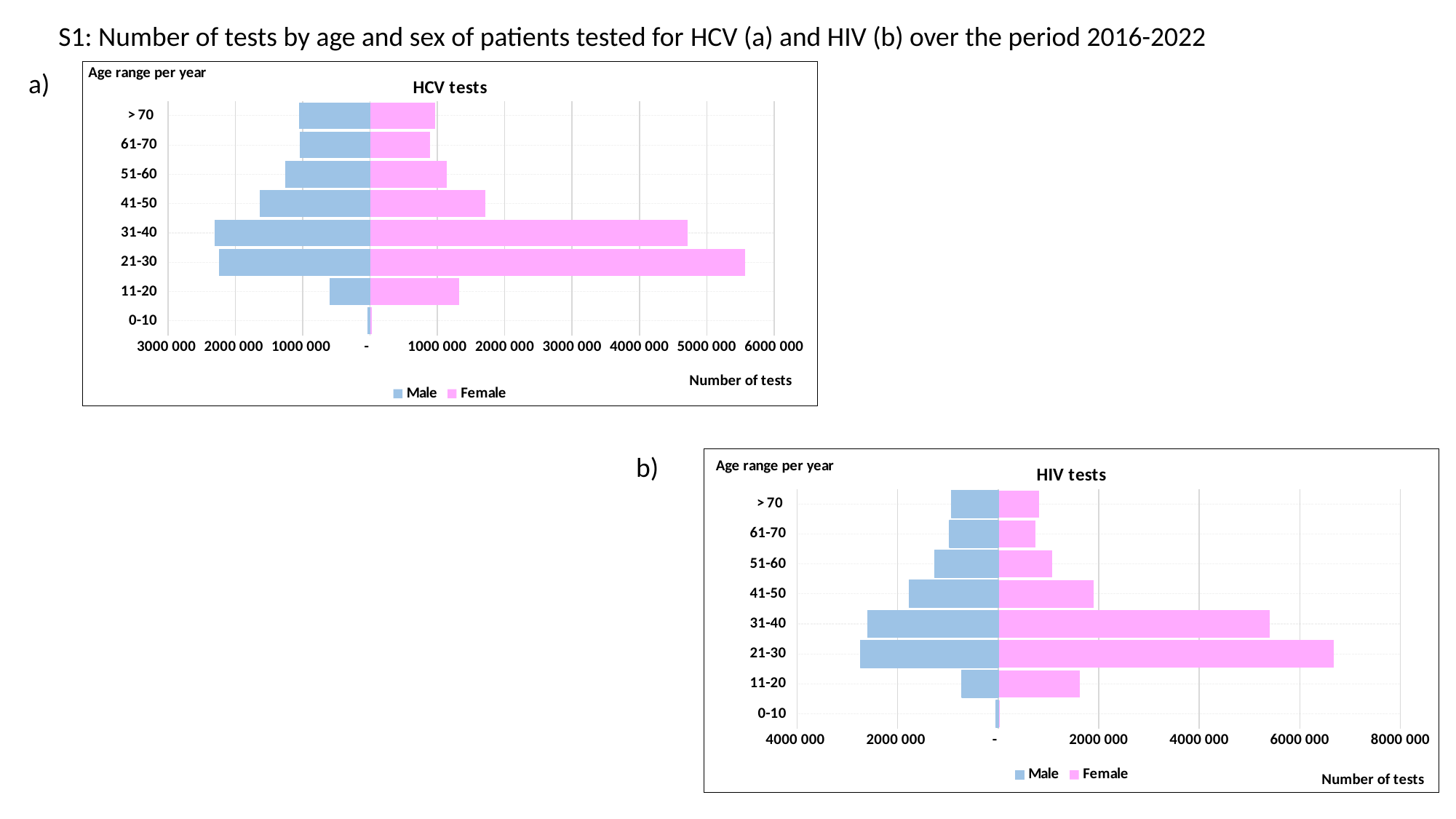
On the HIV tests chart, which age range has the lowest number of Male tests? 0-10 What is the x-axis label of the HIV tests chart? Number of tests On the HIV tests chart, for the 31-40 age range, which is larger: the Male value or the Female value? Female What kind of chart is the HCV tests chart? bar chart On the HIV tests chart, is the Female value for 21-30 greater or less than 6000000? greater How many age range categories are shown on the HIV tests chart? 8 On the HCV tests chart, which age range has the highest number of Female tests? 21-30 On the HCV tests chart, which is larger: the Female value for 21-30 or the Female value for 41-50? 21-30 How many series does the legend of the HCV tests chart list? 2 On the HCV tests chart, is the Female value for 61-70 greater or less than 1000000? less On the HCV tests chart, is the Female value for 21-30 greater or less than 5000000? greater